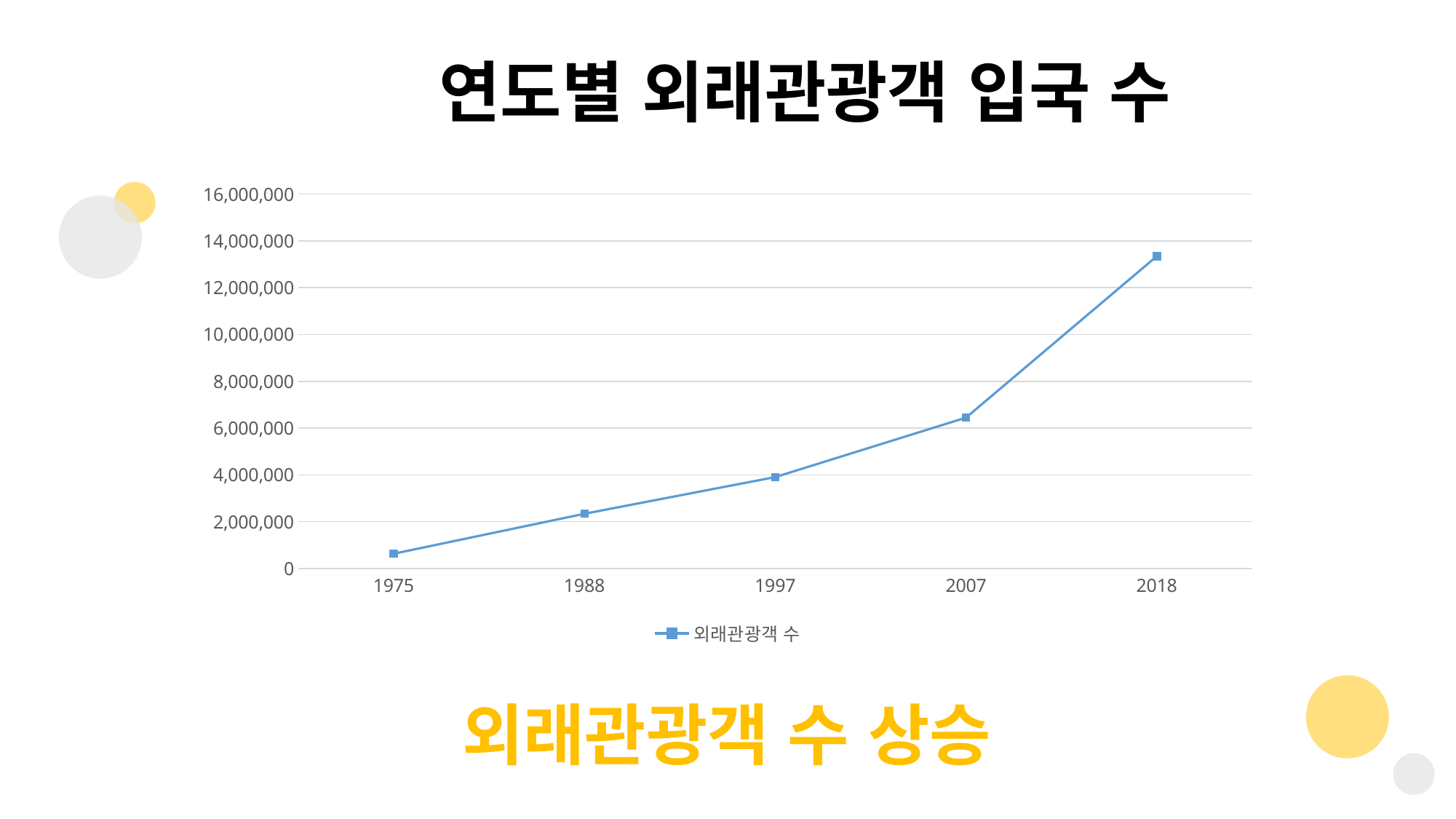
Is the value for 2018 greater or less than 14,000,000? less What kind of chart is shown on the slide? line chart Is the value for 2007 greater or less than 6,000,000? greater Which is larger, the value for 1988 or the value for 1997? 1997 Is the value for 1975 greater or less than 2,000,000? less Which year has the lowest value? 1975 Which year has the highest value? 2018 How many years are plotted on the x axis? 5 What is the name of the series shown in the legend? 외래관광객 수 Do the values rise or fall from 1975 to 2018? rise What is the title of the chart? 연도별 외래관광객 입국 수 How many series does the legend list? 1